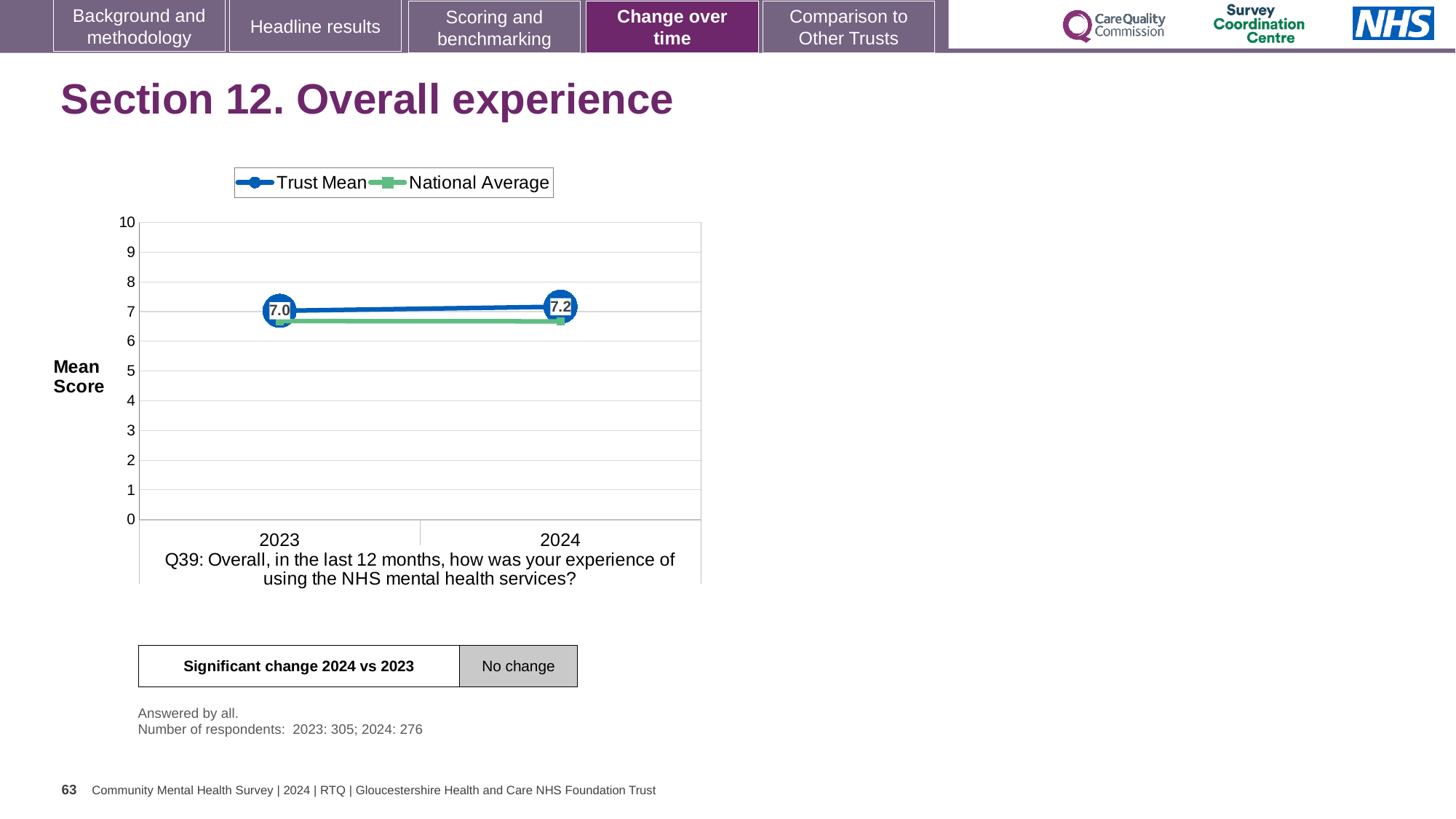
In which year is the Trust Mean higher? 2024 What is the Trust Mean value for 2023? 7.0 By how much did the Trust Mean change from 2023 to 2024? 0.2 What kind of chart is shown on the slide? line chart How many series does the legend list? 2 What is the Trust Mean value for 2024? 7.2 What is the label on the y axis of the chart? Mean Score In which year is the Trust Mean lower? 2023 In 2024, which is higher: the Trust Mean or the National Average? Trust Mean Does the Trust Mean rise or fall from 2023 to 2024? rise How many years are plotted on the x axis? 2 Is the National Average value for 2024 greater or less than 7? less